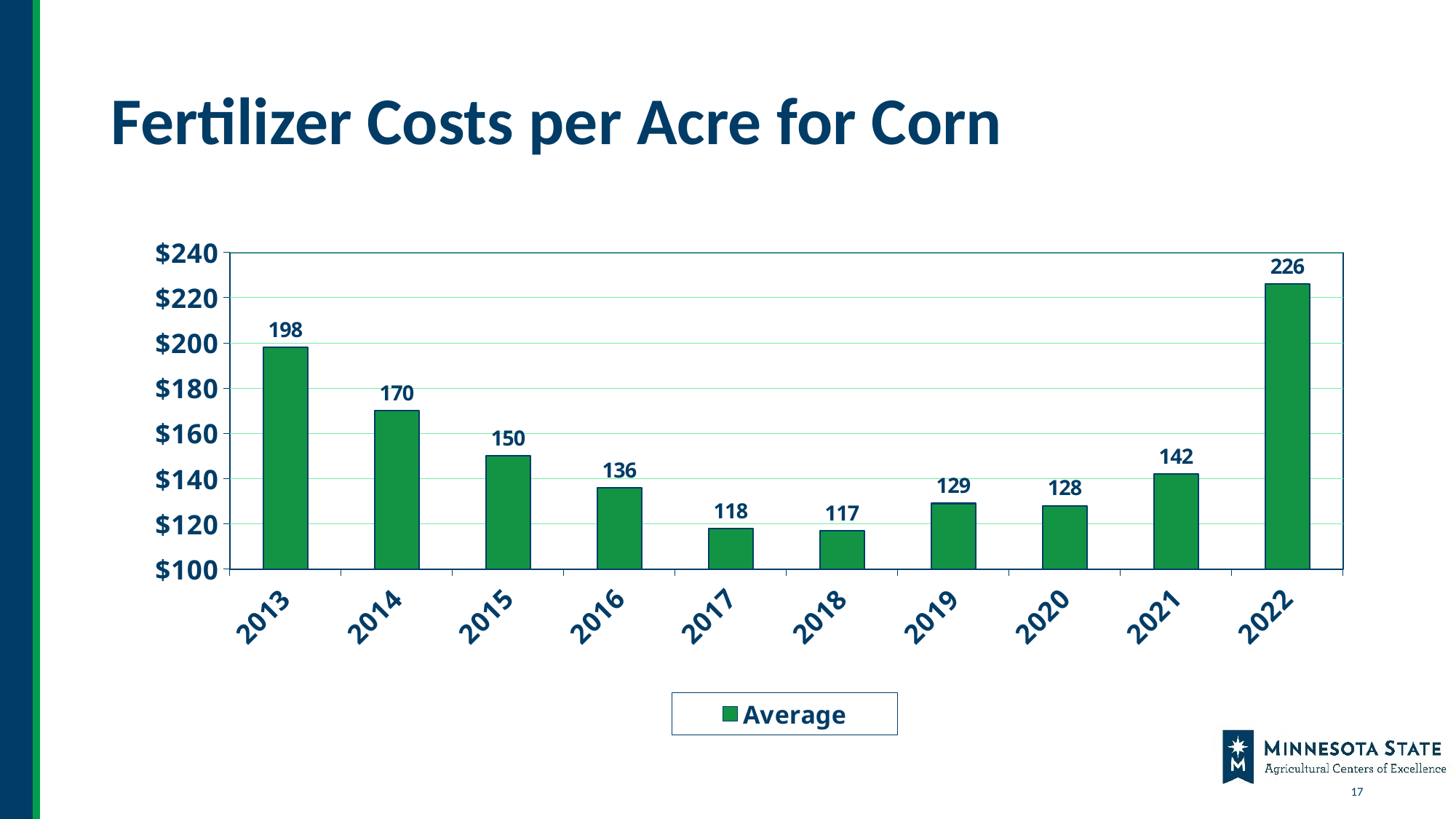
What is the value shown for 2021? 142 Which year has a larger value, 2015 or 2016? 2015 What is the fertilizer cost per acre for corn in 2013? 198 What is the name of the series in the legend? Average Is the value for 2019 greater or less than $140? less How many years are shown on the x axis? 10 Which year has the lowest fertilizer cost per acre? 2018 Which year has the highest fertilizer cost per acre? 2022 What is the difference between the 2022 value and the 2013 value? 28 How many series does the legend list? 1 What kind of chart is shown on the slide? bar chart What is the value shown for 2018? 117